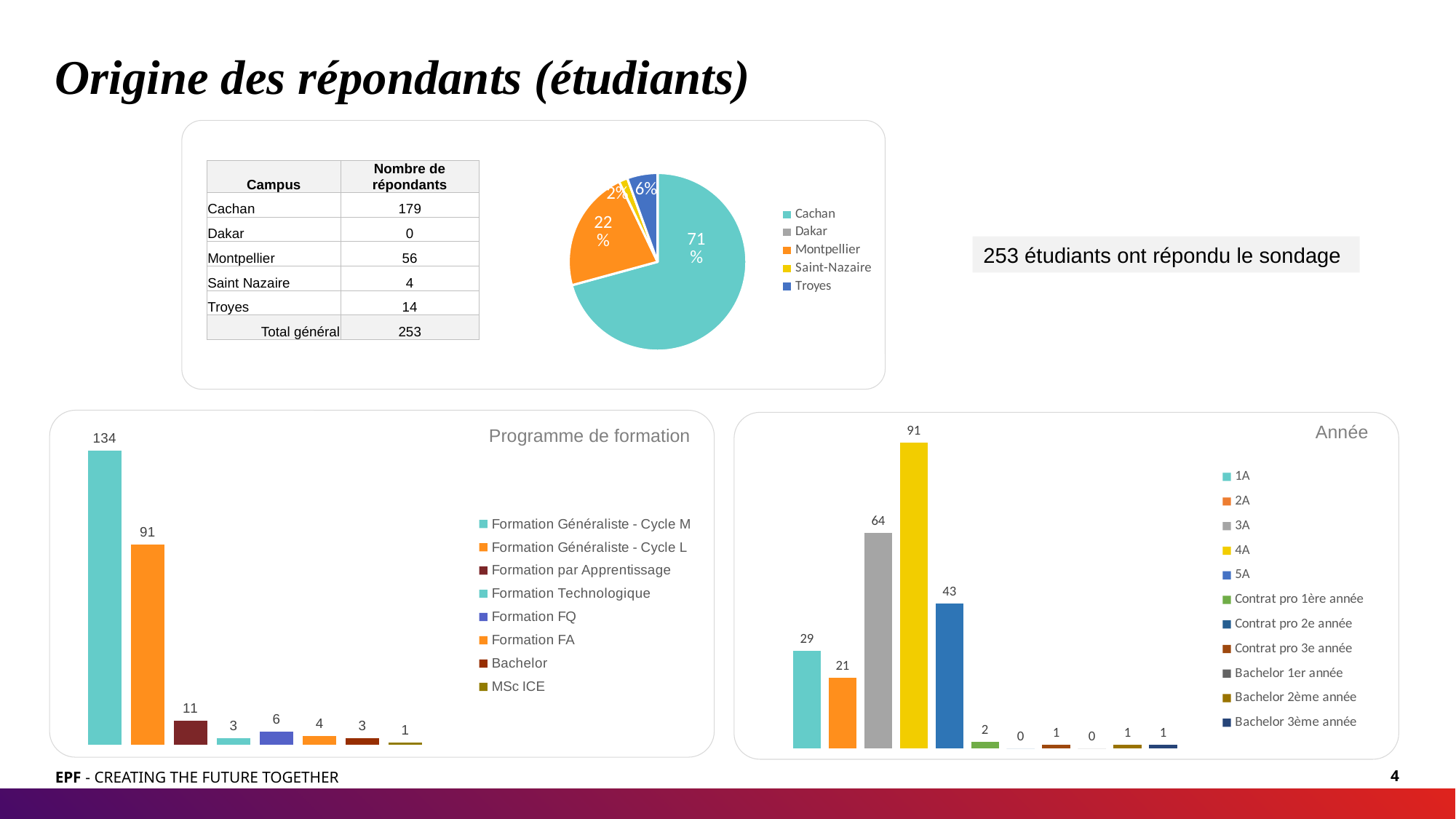
In the 'Programme de formation' chart, what is the difference between Formation Généraliste - Cycle M and Formation Généraliste - Cycle L? 43 In the 'Année' chart, which is larger, 1A or 2A? 1A In the pie chart, what share of respondents comes from Montpellier? 22% In the 'Année' chart, what is the value for 4A? 91 In the 'Programme de formation' chart, which category has the highest value? Formation Généraliste - Cycle M In the pie chart, what share of respondents comes from Cachan? 71% In the 'Année' chart, what is the difference between 4A and 5A? 48 How many entries does the legend of the pie chart list? 5 In the 'Programme de formation' chart, what is the value for Formation Généraliste - Cycle M? 134 What kind of chart is the 'Programme de formation' chart? Bar chart How many entries does the legend of the 'Année' chart list? 11 In the 'Année' chart, what is the value for 3A? 64